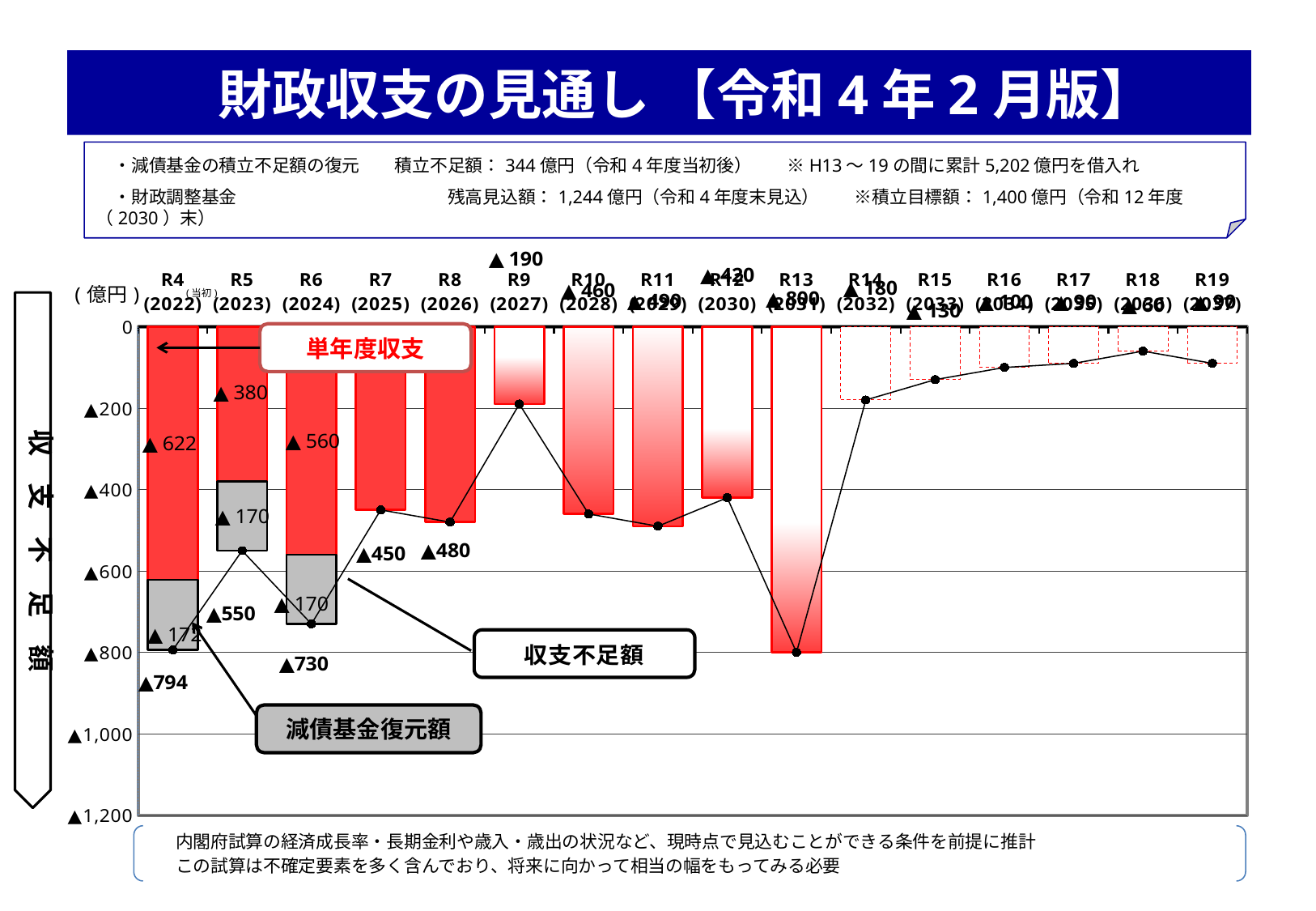
What is the 単年度収支 (red bar) value for R6 (2024)? ▲560 What is the 減債基金復元額 (gray bar) value for R5 (2023)? ▲170 What is the 収支不足額 (line value) for R4 (2022)? ▲794 Which has the larger 収支不足額, R7 (2025) or R8 (2026)? R8 (2026) What is the difference between the 収支不足額 for R4 (2022) and R5 (2023)? 244 How many fiscal years are shown on the x axis? 16 What is the total of the stacked bar for R4 (2022), combining 単年度収支 and 減債基金復元額? ▲794 Which year has the smallest 収支不足額 on the line? R18 (2036) What is the title of the slide? 財政収支の見通し【令和4年2月版】 What is the 収支不足額 value for R9 (2027)? ▲190 What kind of chart is this? Stacked bar chart with a line Which year has the largest 収支不足額 on the line? R13 (2031)